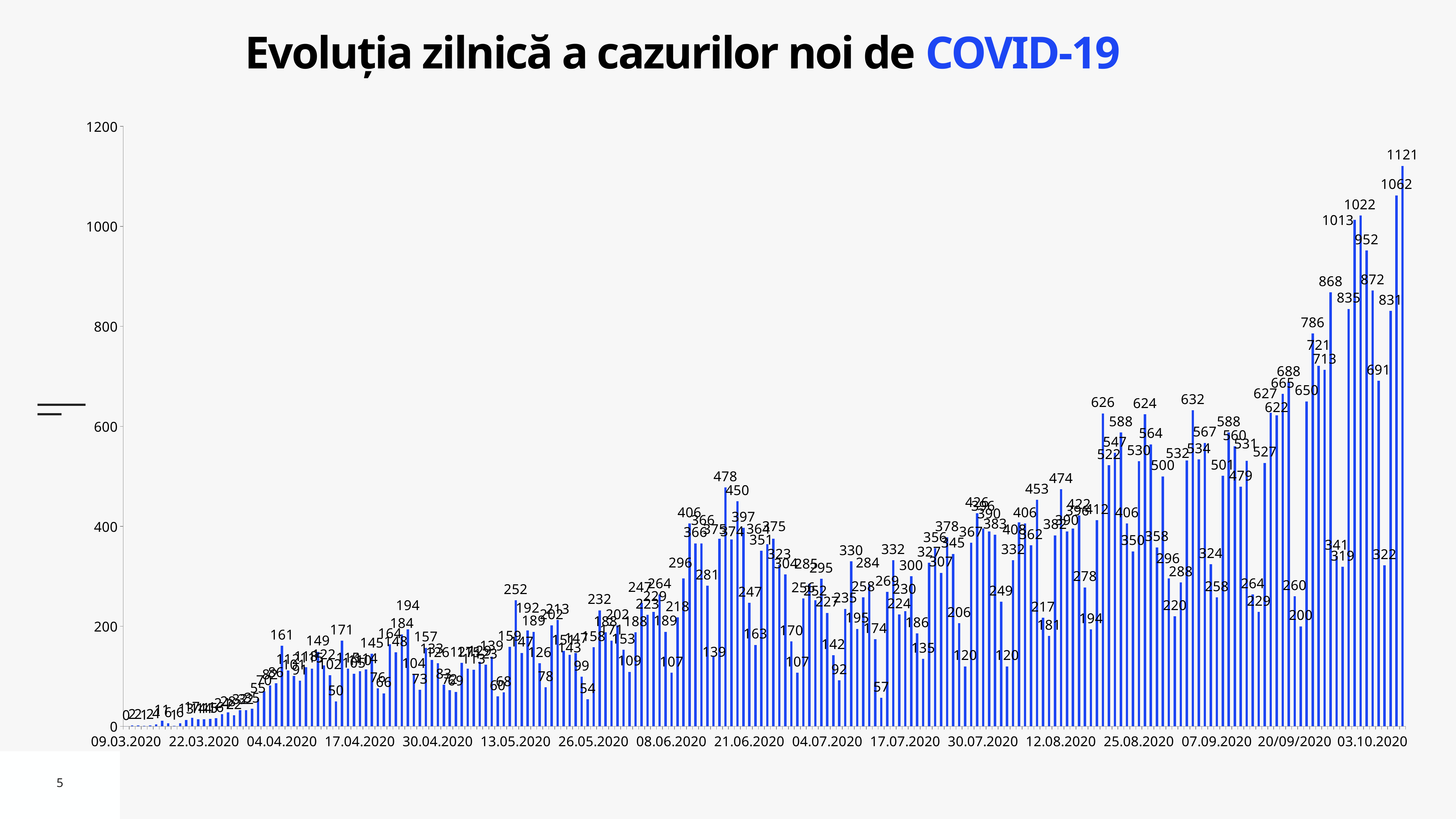
How much higher is the highest value (1121) than the late-June peak of 478? 643 What kind of chart is shown on the slide? bar chart What is the title of the chart? Evoluția zilnică a cazurilor noi de COVID-19 What is the highest daily value shown on the chart? 1121 What is the lowest daily value shown on the chart? 0 What is the value of the first bar, at 09.03.2020? 0 What is the difference between the two highest values on the chart, 1121 and 1062? 59 Is the highest bar on the chart greater or less than 1000? greater How many data series are plotted on the chart? 1 Do the daily values generally rise or fall from 09.03.2020 to 03.10.2020? rise What is the highest tick value shown on the vertical axis? 1200 Which is larger, the late-June peak of 478 or the late-August peak of 626? 626